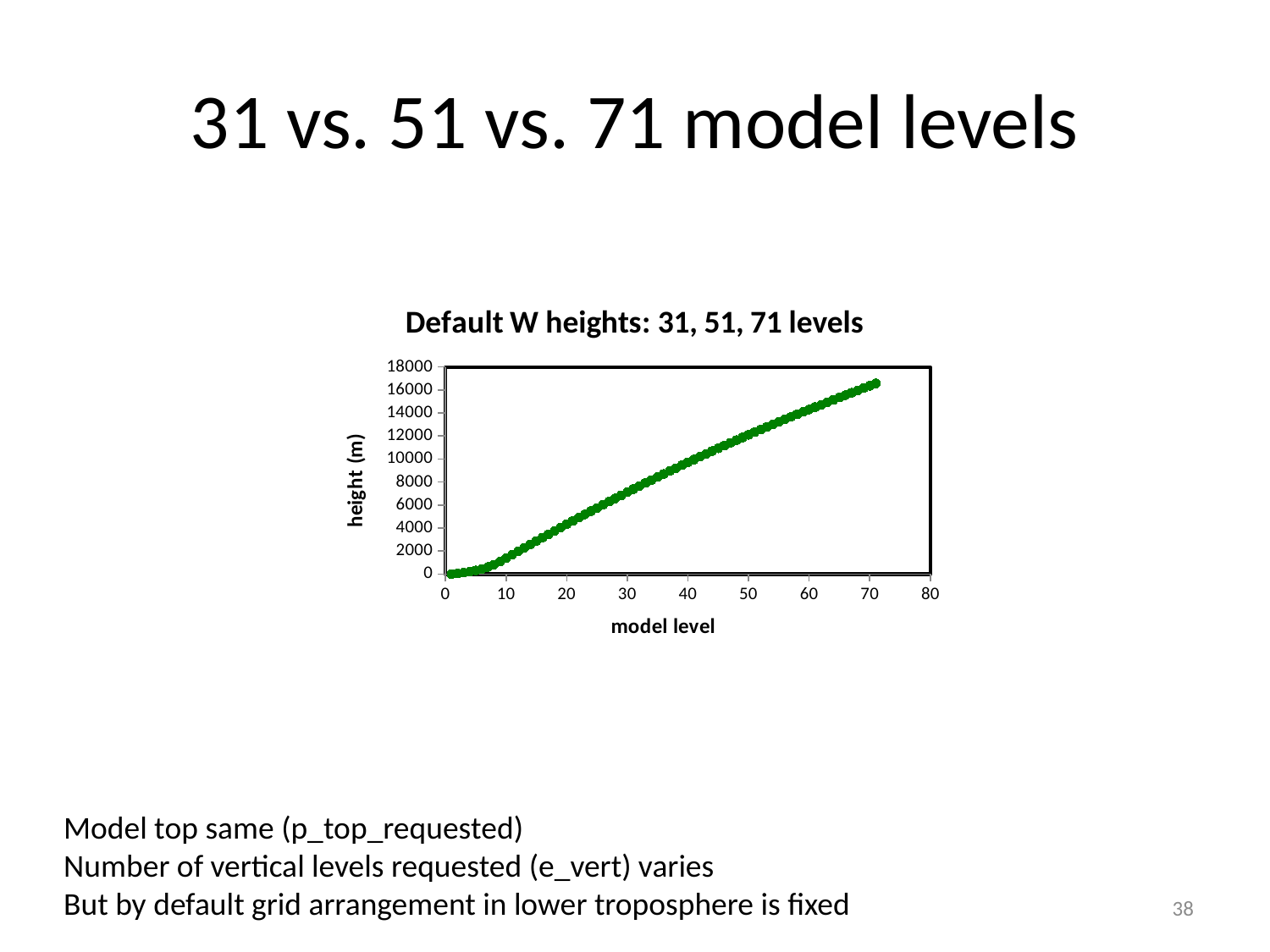
What is the title of the chart? Default W heights: 31, 51, 71 levels Is the height at model level 20 greater or less than 6000? less Which has the greater height, model level 30 or model level 60? model level 60 Is the height at model level 5 greater or less than 2000? less Is the height at model level 60 greater or less than 10000? greater Do the plotted heights rise or fall as the model level increases along the x axis? rise What kind of chart is shown on the slide? scatter chart What is the label of the vertical axis of the chart? height (m)